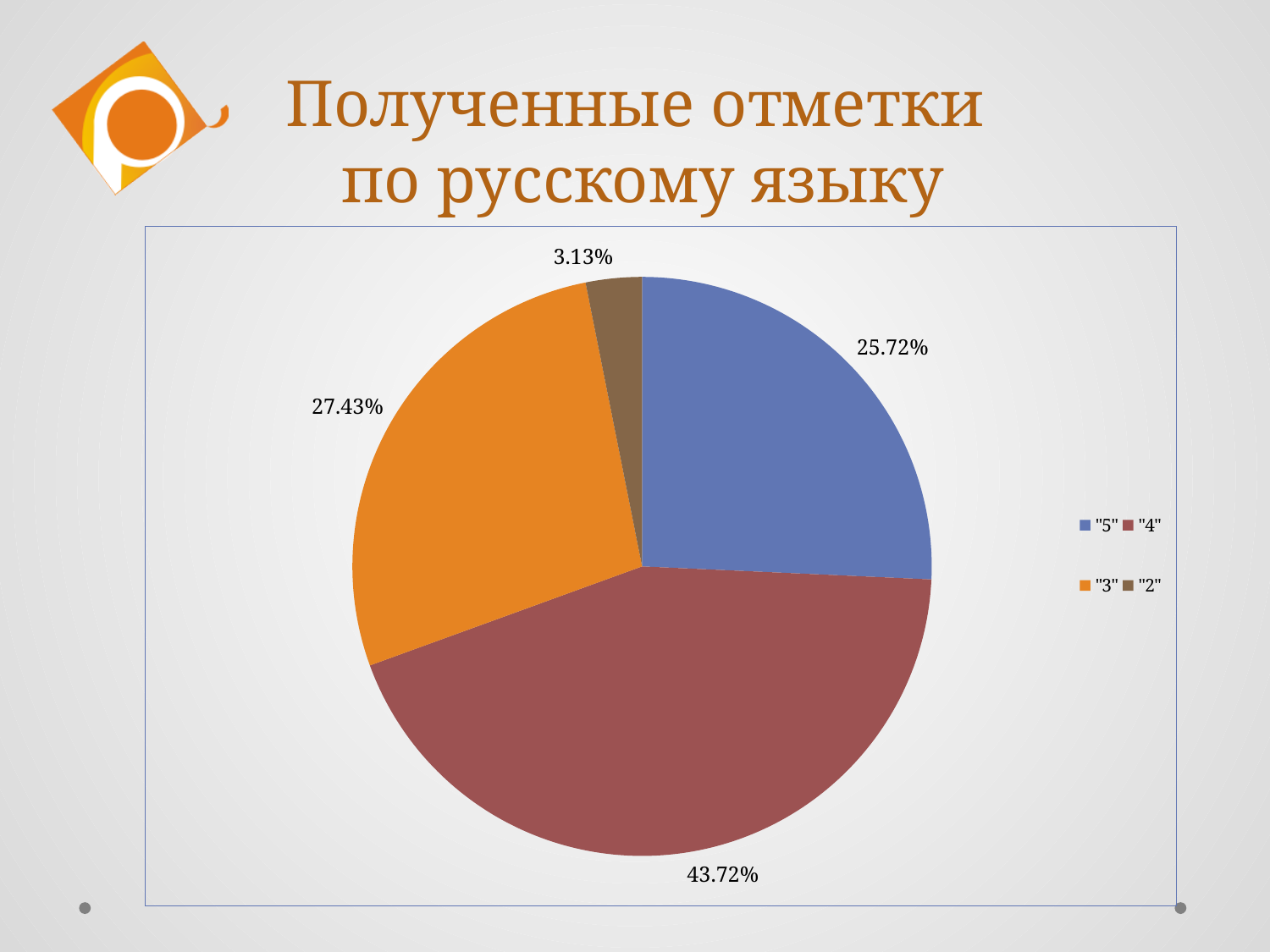
What is the value shown for the "5" slice? 25.72% What is the difference in percentage points between the "3" slice and the "2" slice? 24.30 What is the value shown for the "2" slice? 3.13% What is the value shown for the "3" slice? 27.43% How many slices does the pie chart have? 4 What is the title of the slide containing the chart? Полученные отметки по русскому языку What share of the pie does the "4" slice represent? 43.72% What kind of chart is shown on the slide? Pie chart Which is larger, the share for "4" or the share for "3"? "4" Which grade has the largest share of the pie? "4" What is the difference in percentage points between the "4" slice and the "5" slice? 18.00 Which grade has the smallest share of the pie? "2"